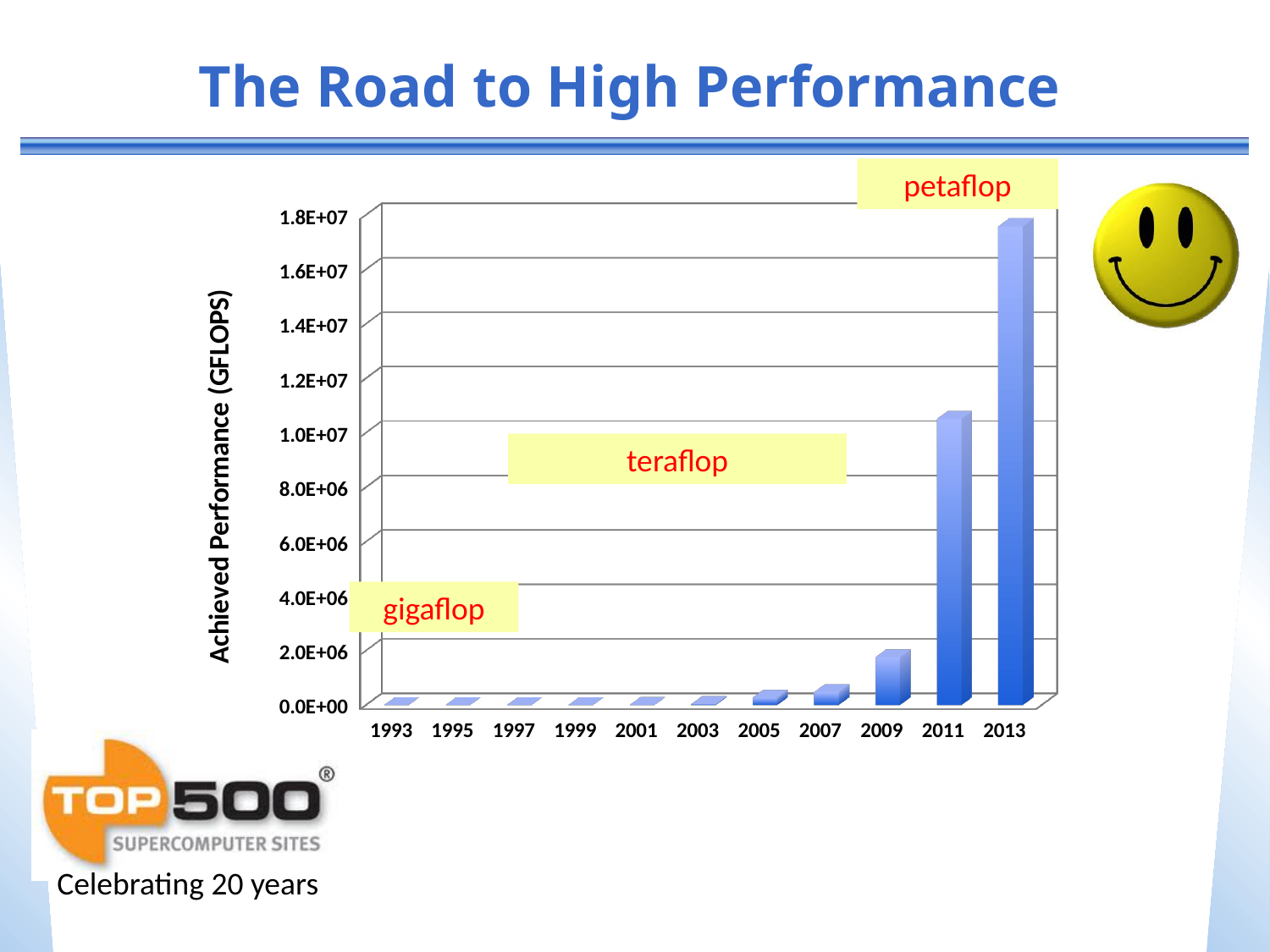
Is the value for 2007 greater or less than 2.0E+06? less What kind of chart is shown on the slide? bar chart Is the value for 2011 greater or less than 8.0E+06? greater Which year has the larger achieved performance, 2007 or 2009? 2009 Do the values in the chart generally rise or fall from 1993 to 2013? rise What are the three performance milestones annotated on the chart? gigaflop, teraflop, petaflop Which year has the highest achieved performance in the chart? 2013 Is the value for 2009 greater or less than 4.0E+06? less Which year has the larger achieved performance, 2011 or 2013? 2013 How many years are shown on the x axis of the chart? 11 What is the label of the vertical axis of the chart? Achieved Performance (GFLOPS)